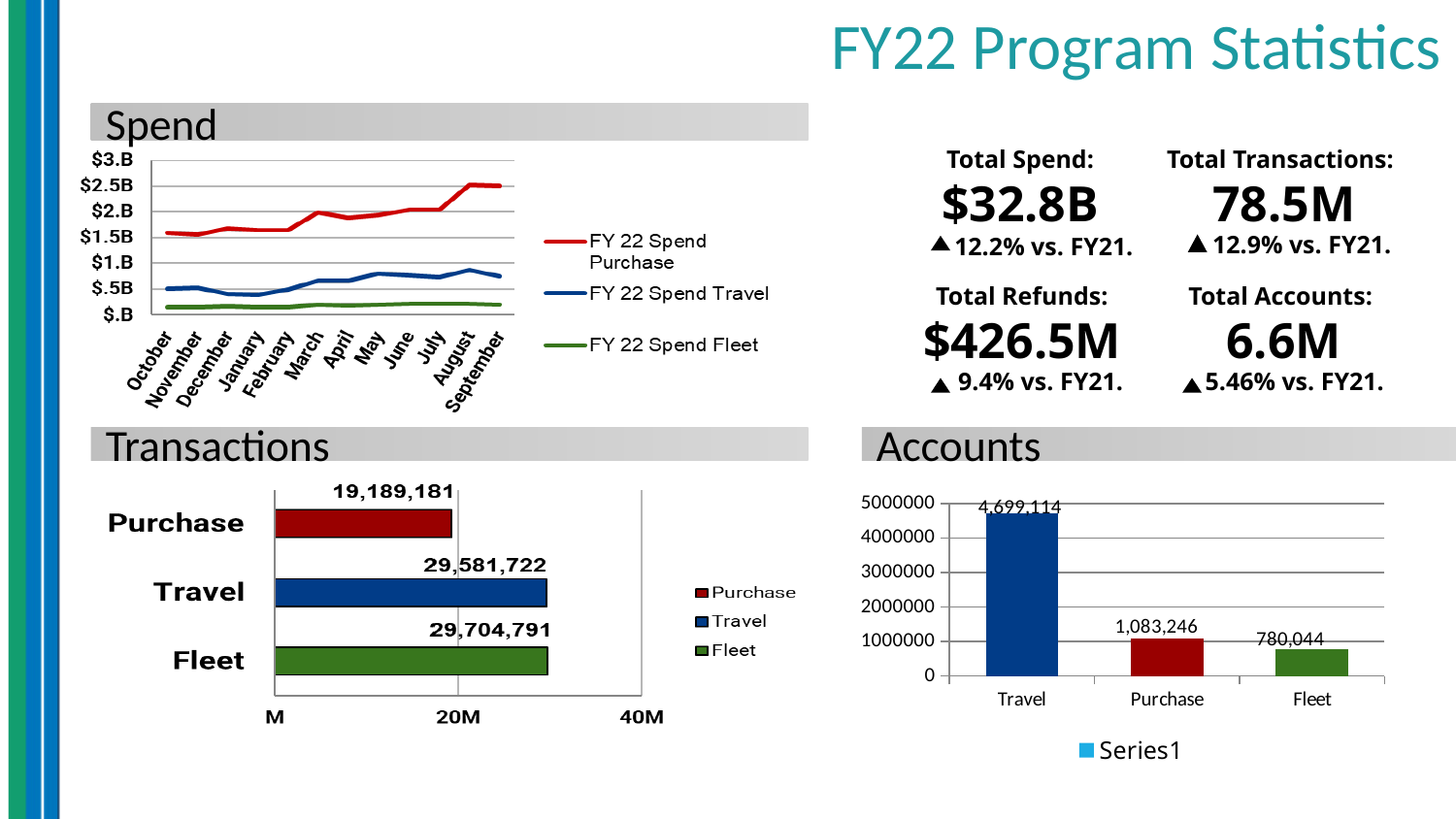
How many series does the legend of the Spend chart list? 3 In the Accounts chart, what is the value for Travel? 4,699,114 In the Transactions chart, what is the value for Purchase? 19,189,181 In the Accounts chart, which category has the highest value? Travel In the Spend chart, does the FY 22 Spend Purchase line generally rise or fall from October to September? rise In the Accounts chart, what is the difference between the Travel and Purchase values? 3,615,868 What kind of chart is the Accounts chart? bar chart In the Transactions chart, which category has the lowest value? Purchase In the Transactions chart, what is the value for Fleet? 29,704,791 In the Accounts chart, what is the value for Fleet? 780,044 In the Transactions chart, what is the difference between the Fleet and Purchase values? 10,515,610 In the Accounts chart, is the value for Purchase greater or less than 1000000? greater